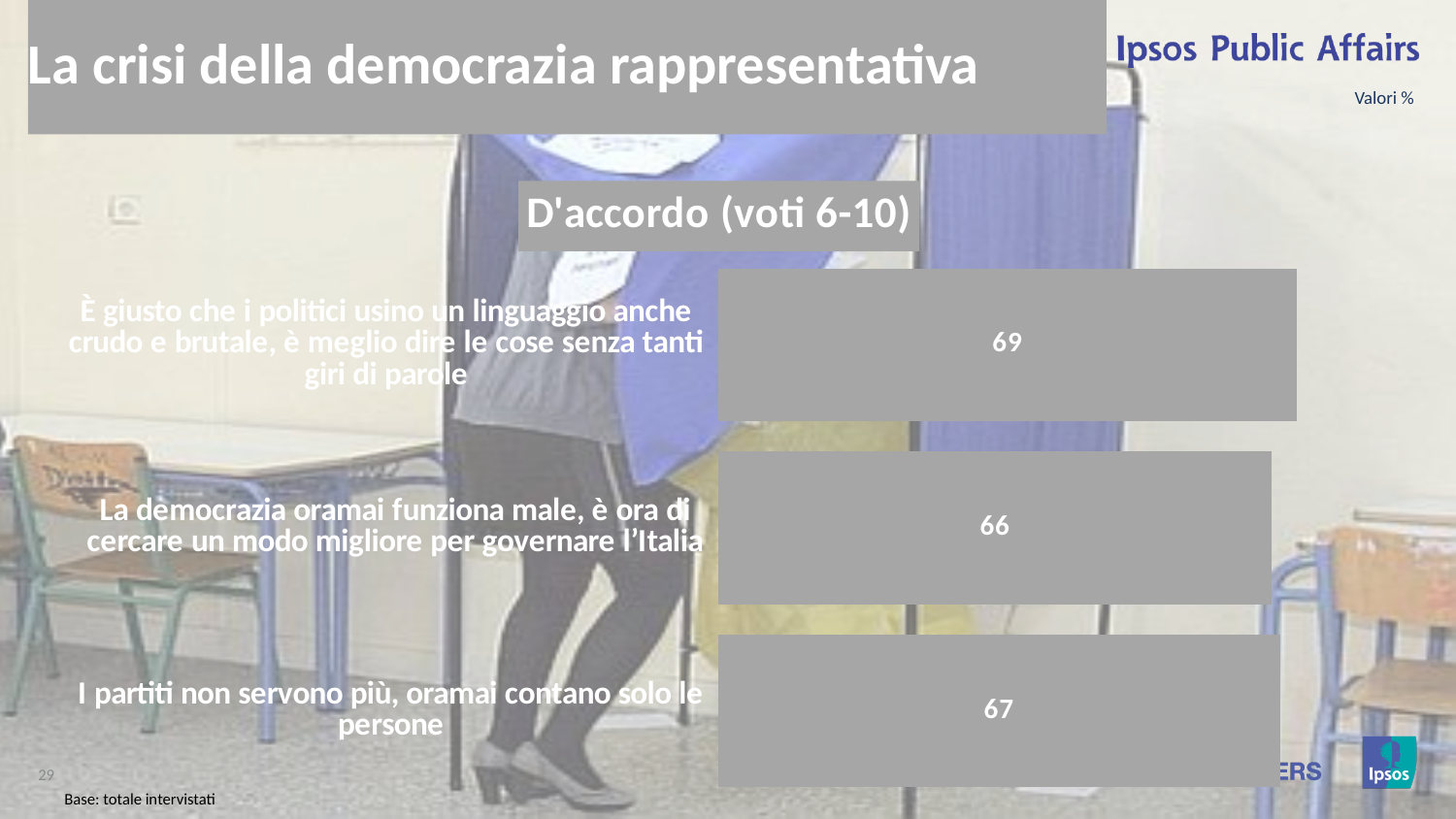
What kind of chart is shown on the slide? Bar chart What is the title of the chart? D'accordo (voti 6-10) What value is shown for the statement "I partiti non servono più, oramai contano solo le persone"? 67 What value is shown for the statement "È giusto che i politici usino un linguaggio anche crudo e brutale, è meglio dire le cose senza tanti giri di parole"? 69 How many statements are shown in the chart? 3 Which statement has the highest share of agreement? È giusto che i politici usino un linguaggio anche crudo e brutale, è meglio dire le cose senza tanti giri di parole In what unit are the chart values expressed, according to the note at the top right? Valori % What value is shown for the statement "La democrazia oramai funziona male, è ora di cercare un modo migliore per governare l'Italia"? 66 Which statement has the lowest share of agreement? La democrazia oramai funziona male, è ora di cercare un modo migliore per governare l'Italia What is the difference between the value for "È giusto che i politici usino un linguaggio anche crudo e brutale..." and the value for "La democrazia oramai funziona male..."? 3 Which has a larger value: "I partiti non servono più, oramai contano solo le persone" or "La democrazia oramai funziona male..."? I partiti non servono più, oramai contano solo le persone What is the difference between the value for "I partiti non servono più, oramai contano solo le persone" and the value for "La democrazia oramai funziona male..."? 1